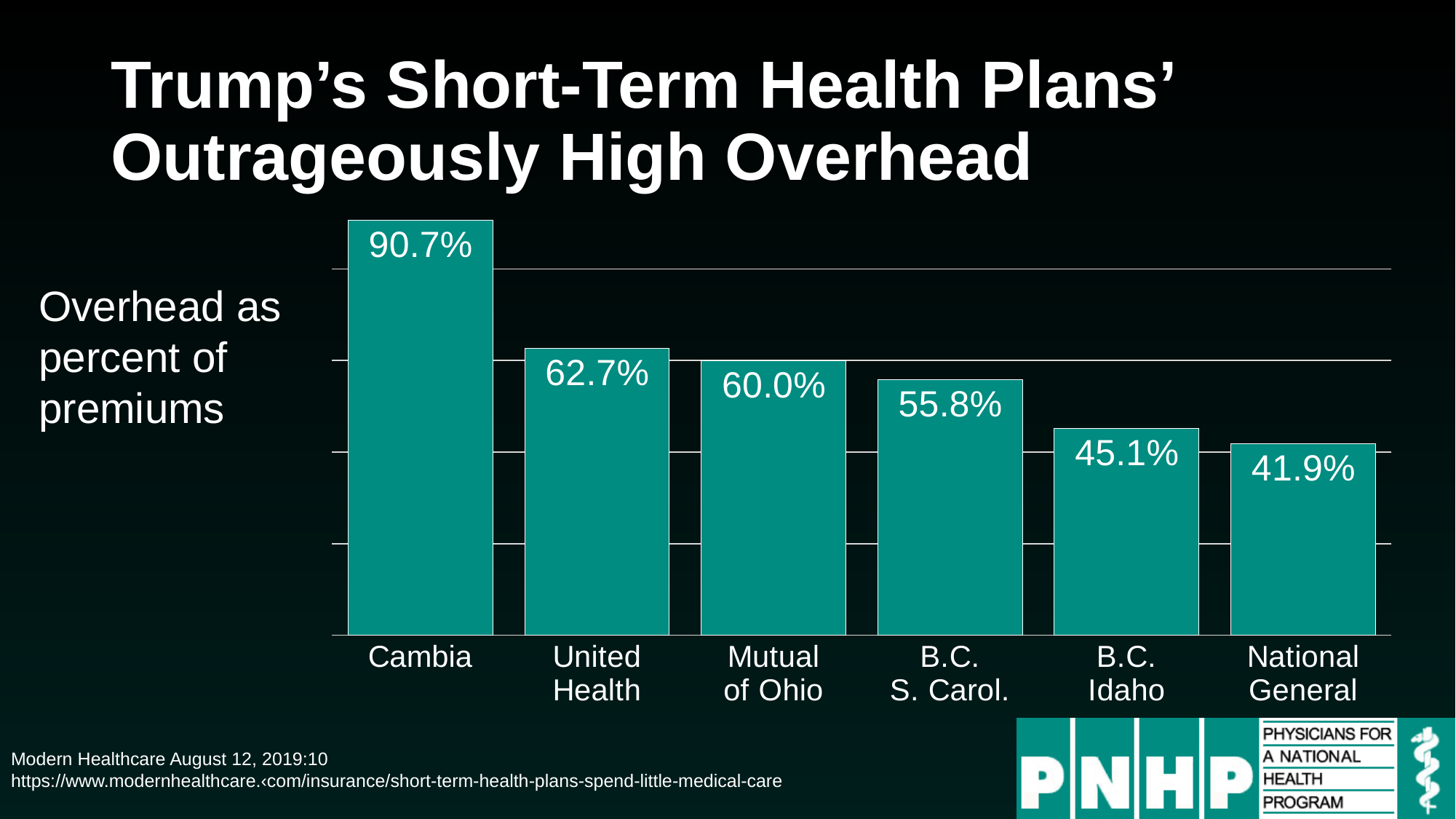
What is the difference in overhead percentage between Cambia and United Health? 28.0% What is the overhead as percent of premiums for Cambia? 90.7% What is the overhead as percent of premiums for Mutual of Ohio? 60.0% Which plan has the lowest overhead as percent of premiums? National General How many plans are shown in the chart? 6 What kind of chart is shown on the slide? Bar chart Which has a higher overhead as percent of premiums, United Health or B.C. Idaho? United Health What is the overhead as percent of premiums for B.C. Idaho? 45.1% Do the values rise or fall from left to right across the chart? Fall What is the difference in overhead percentage between B.C. S. Carol. and National General? 13.9% Which plan has the highest overhead as percent of premiums? Cambia What is the title of the slide? Trump's Short-Term Health Plans' Outrageously High Overhead